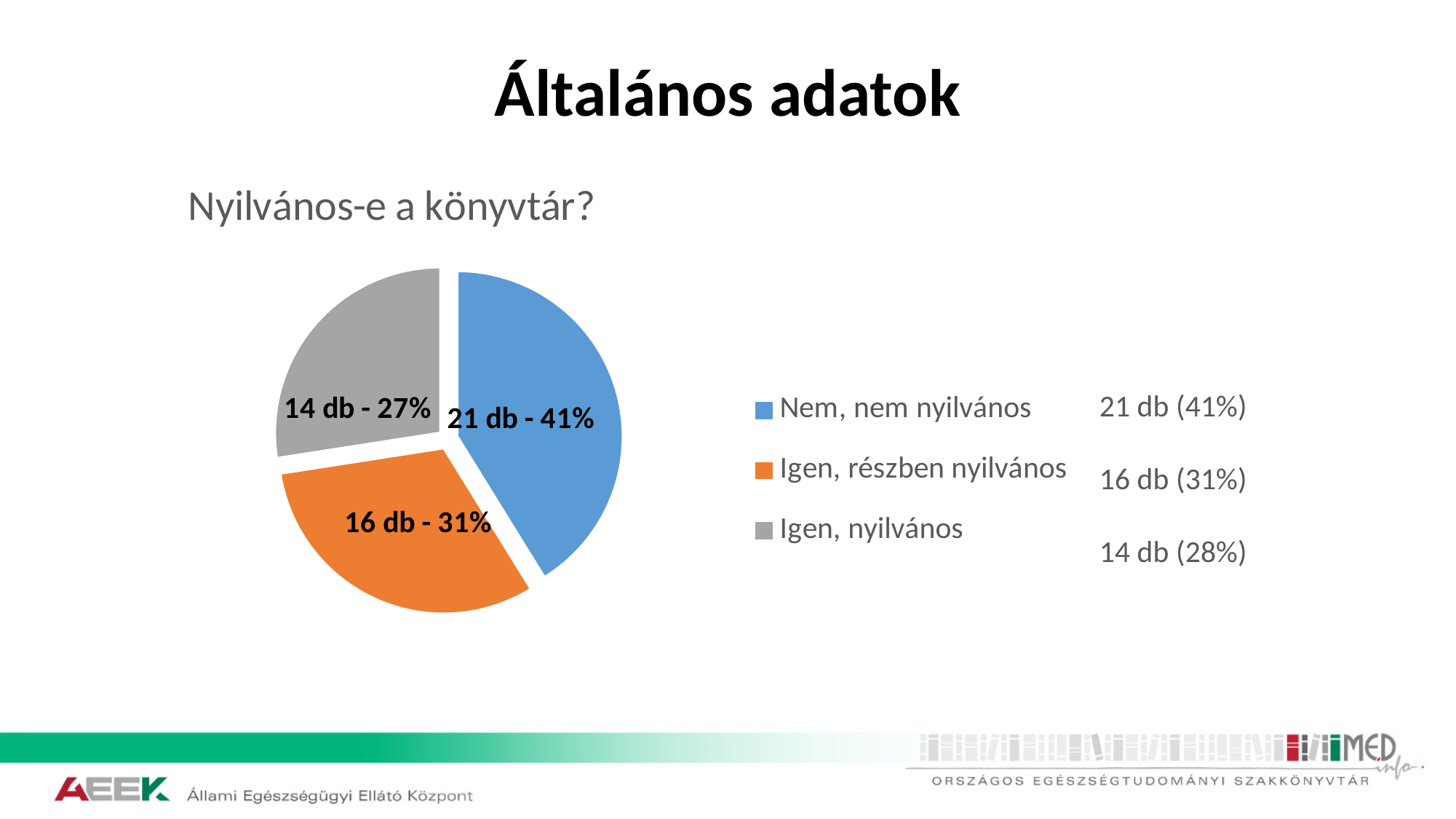
How many libraries (db) are in the 'Nem, nem nyilvános' slice? 21 db How many libraries (db) are in the 'Igen, nyilvános' slice? 14 db Which category has the smallest slice? Igen, nyilvános What kind of chart is shown on the slide? pie chart What is the difference in count between 'Nem, nem nyilvános' and 'Igen, nyilvános'? 7 db How many entries does the legend list? 3 Which category has the largest slice? Nem, nem nyilvános What share of the pie does 'Nem, nem nyilvános' represent according to the chart label? 41% How many libraries (db) are in the 'Igen, részben nyilvános' slice? 16 db How many slices does the pie chart have? 3 What is the title of the chart? Nyilvános-e a könyvtár? What share of the pie does 'Igen, részben nyilvános' represent according to the chart label? 31%